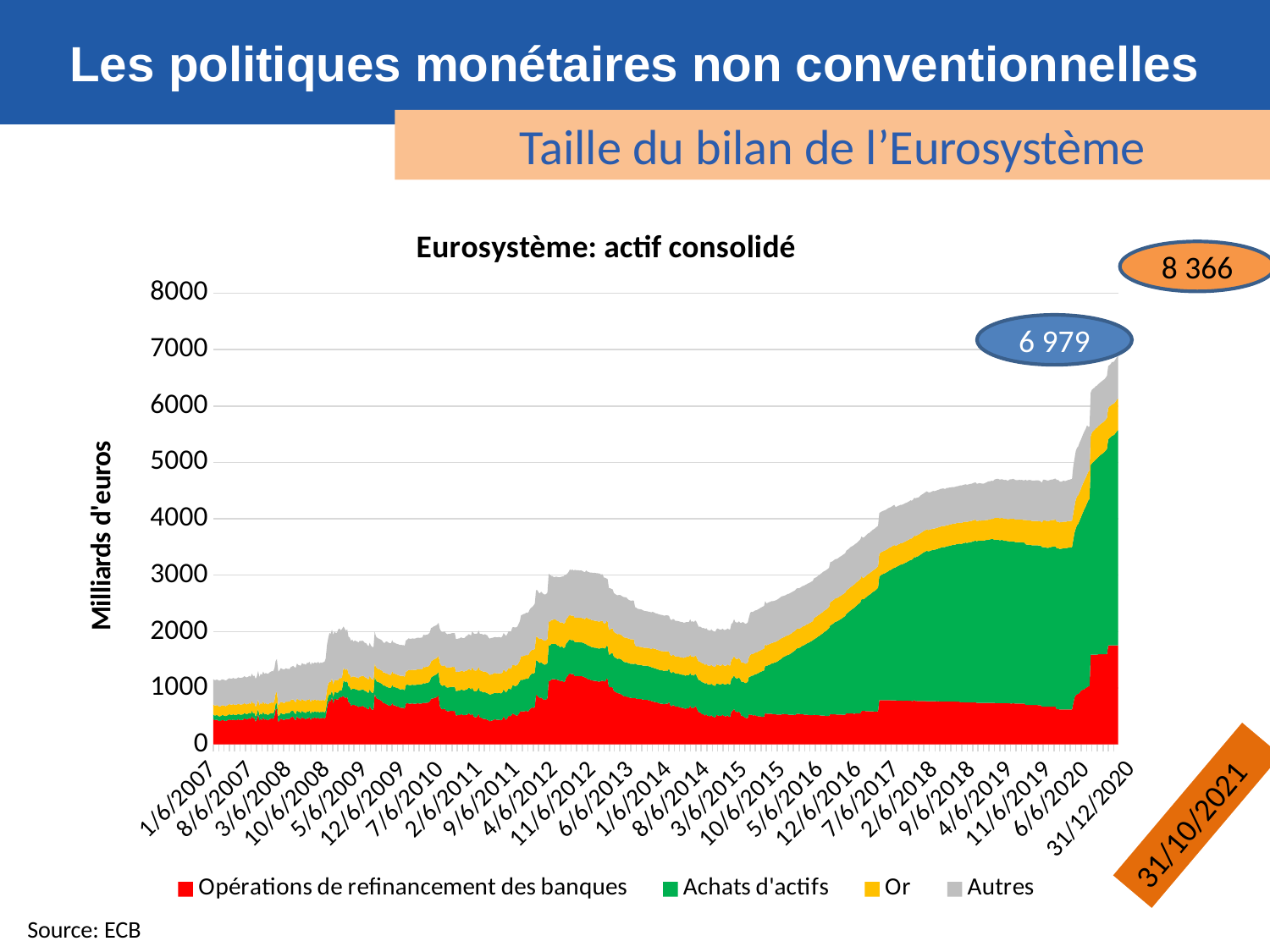
Is the total value at 1/6/2007 greater or less than 2000? less Is the total value at 31/12/2020 greater or less than 6000? greater Overall, does the total consolidated asset value rise or fall from 1/6/2007 to 31/12/2020? Rise What kind of chart is shown on the slide? Stacked area chart What is the label of the vertical axis? Milliards d'euros Is the value for 'Opérations de refinancement des banques' at 31/12/2020 greater or less than 1000? greater How many series does the chart legend list? 4 Which is larger at 31/12/2020: the 'Achats d'actifs' series or the 'Or' series? Achats d'actifs What is the highest value shown on the vertical axis? 8000 What is the title of the chart? Eurosystème: actif consolidé Which is larger at 1/6/2007: the 'Autres' series or the 'Achats d'actifs' series? Autres